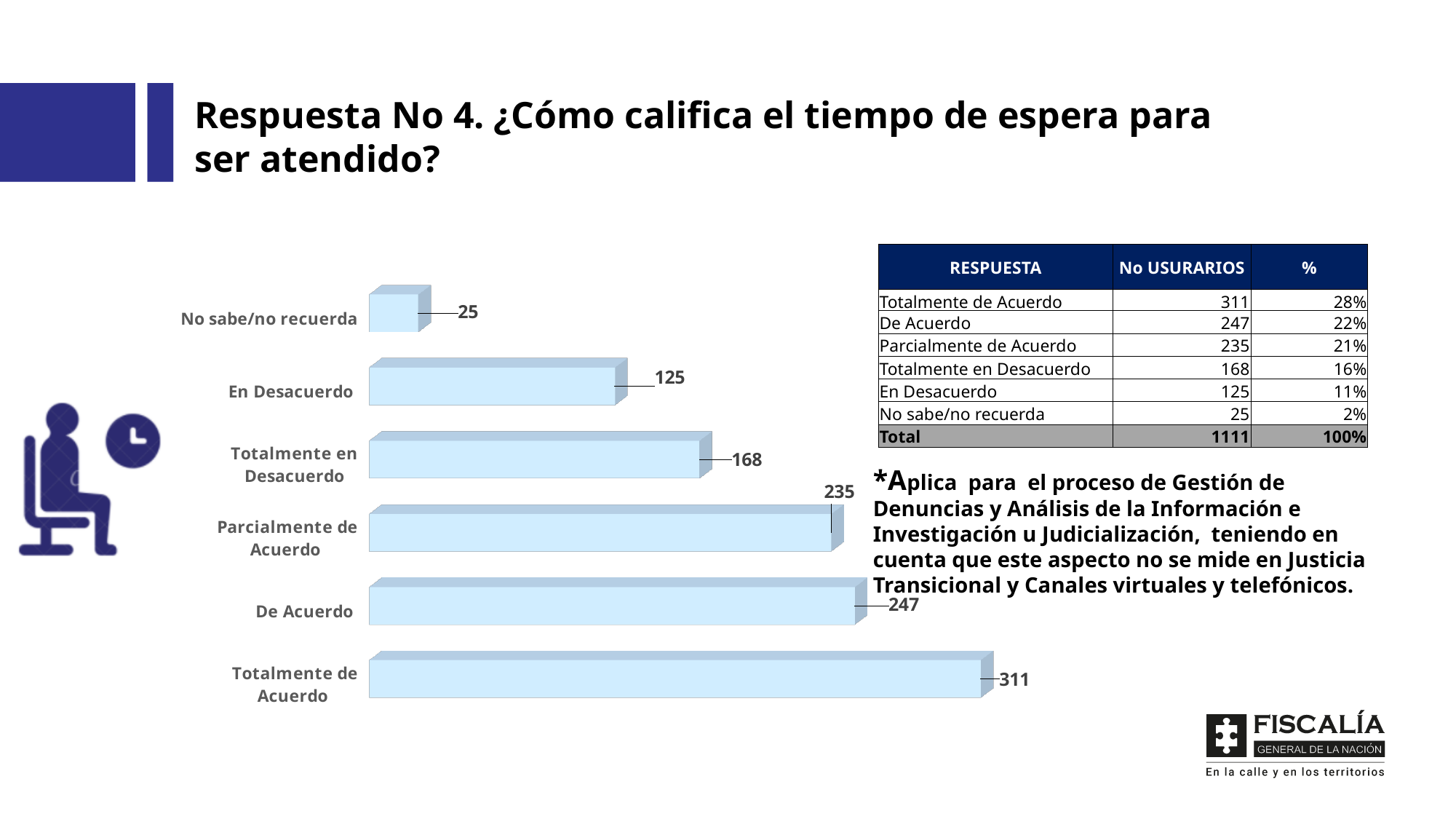
Which category has the highest value? Totalmente de Acuerdo What is the difference between the values for De Acuerdo and Totalmente en Desacuerdo? 79 What is the value for Totalmente en Desacuerdo? 168 Which is larger, the value for Parcialmente de Acuerdo or the value for De Acuerdo? De Acuerdo What is the difference between the values for Totalmente de Acuerdo and No sabe/no recuerda? 286 Which category is listed at the top of the chart? No sabe/no recuerda What is the value for En Desacuerdo? 125 How many categories does the chart show? 6 Which category has the lowest value? No sabe/no recuerda What is the value for Totalmente de Acuerdo? 311 What kind of chart is shown on the slide? Bar chart What is the value for Parcialmente de Acuerdo? 235